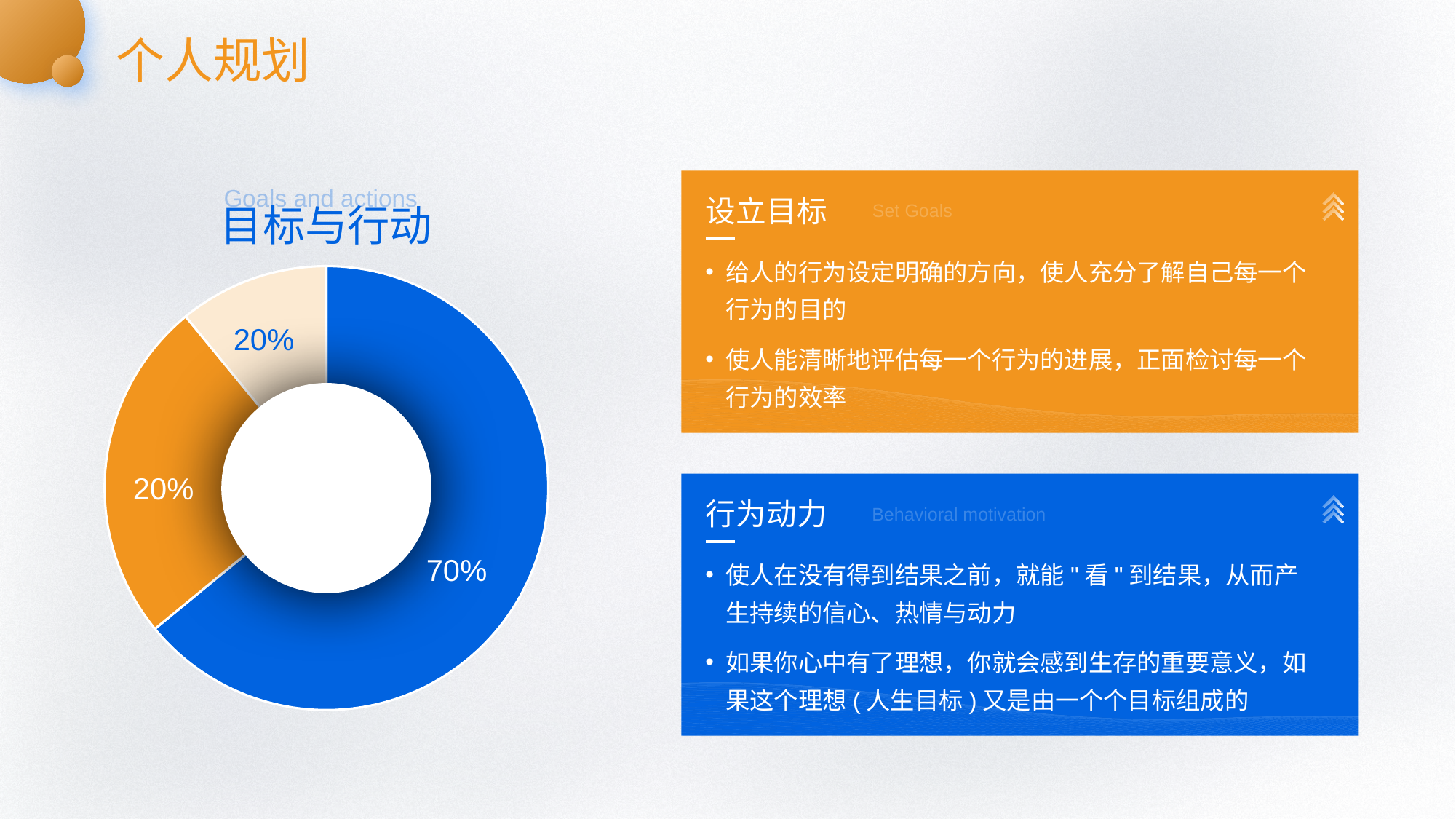
What is the value shown on the blue slice of the doughnut chart? 70% What is the title of the chart? 目标与行动 What is the difference between the blue slice's value and the orange slice's value? 50% What is the English subtitle shown above the chart title? Goals and actions Which is larger, the blue slice or the orange slice? Blue slice What is the value shown on the beige slice of the doughnut chart? 20% What is the largest value labelled on the doughnut chart? 70% What kind of chart is shown on the slide? Doughnut chart Which colour slice is the largest in the doughnut chart? Blue What is the value shown on the orange slice of the doughnut chart? 20% How many slices does the doughnut chart have? 3